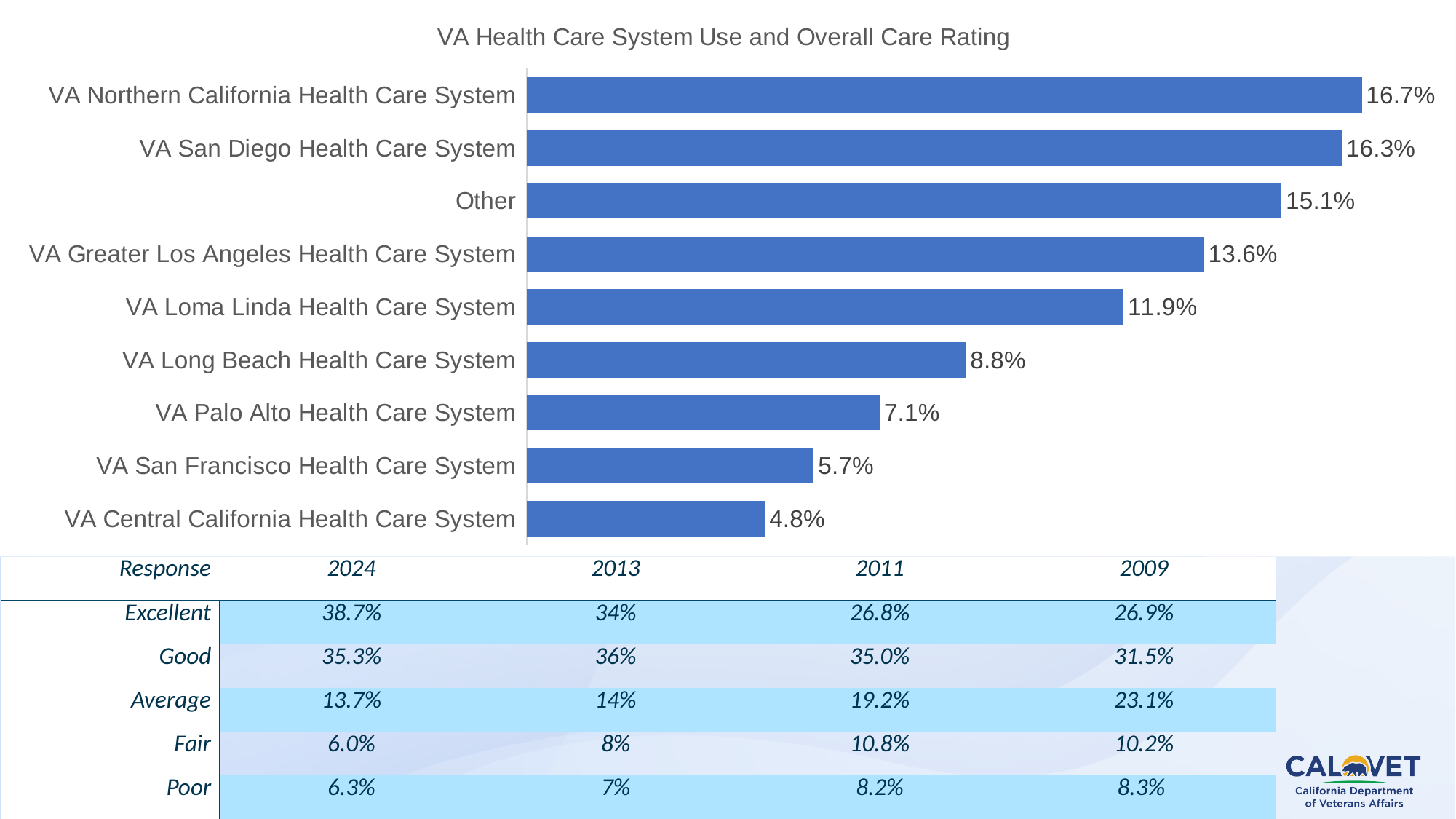
Which is larger, the value for Other or the value for VA Loma Linda Health Care System? Other Which category has the lowest value? VA Central California Health Care System What is the difference between the values for VA San Diego Health Care System and VA San Francisco Health Care System? 10.6% What kind of chart is shown on the slide? Bar chart What is the title of the chart? VA Health Care System Use and Overall Care Rating What is the difference between the values for VA Greater Los Angeles Health Care System and VA Long Beach Health Care System? 4.8% What is the value for VA Central California Health Care System? 4.8% What is the value for VA Loma Linda Health Care System? 11.9% How many categories are shown in the chart? 9 Which category has the highest value? VA Northern California Health Care System What is the value for VA Palo Alto Health Care System? 7.1% What is the value for VA Northern California Health Care System? 16.7%